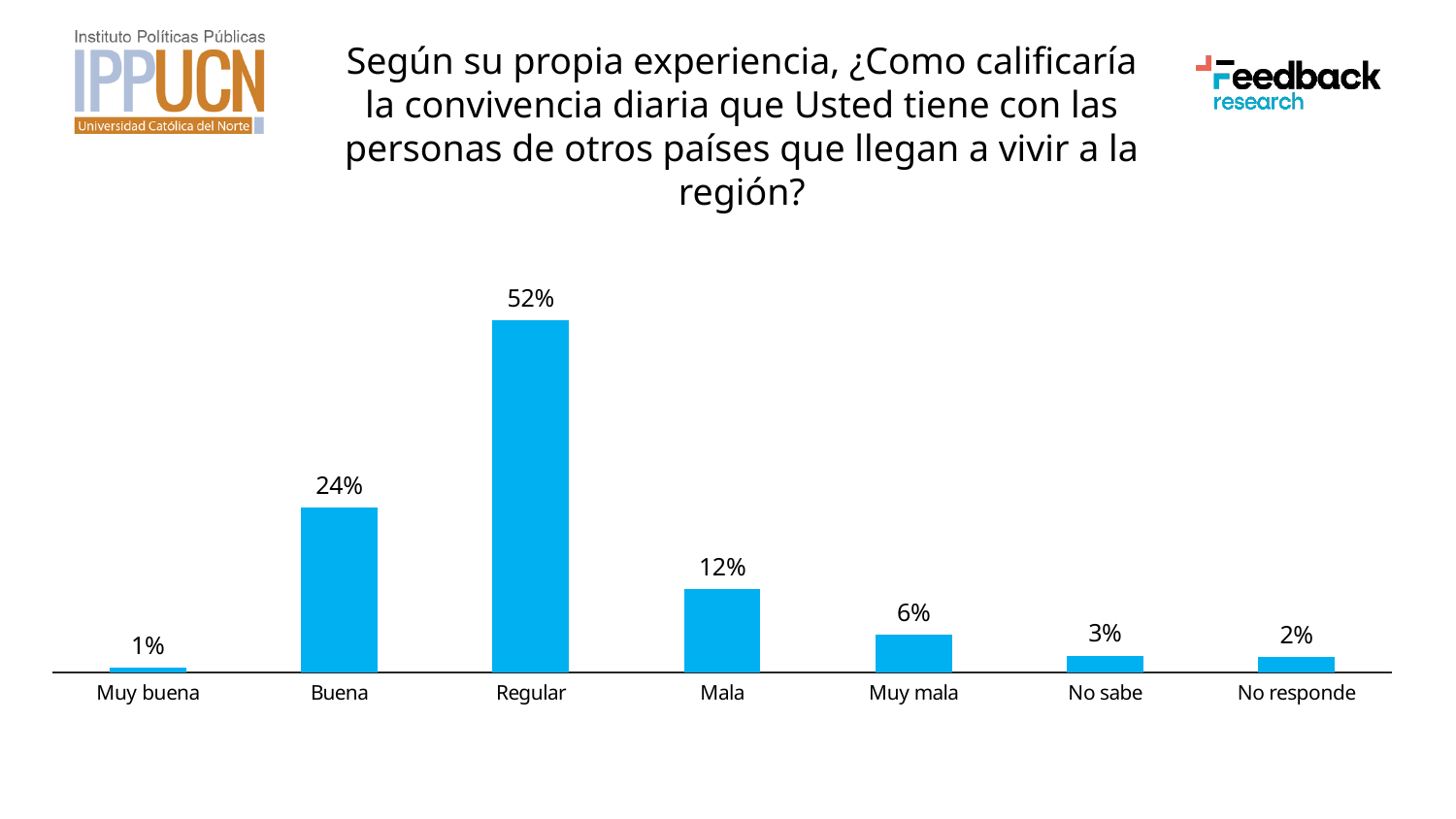
What is the value for Buena? 24% What is the value for Regular? 52% What colour are the bars in the chart? Light blue Which category has the highest value? Regular What is the difference between the values for Regular and Buena? 28% What is the difference between the values for Mala and Muy mala? 6% How many categories are shown on the x axis? 7 Which category has the lowest value? Muy buena What is the value for No responde? 2% Which is larger, the value for Mala or the value for No sabe? Mala What kind of chart is shown on the slide? Bar chart What is the value for Muy mala? 6%